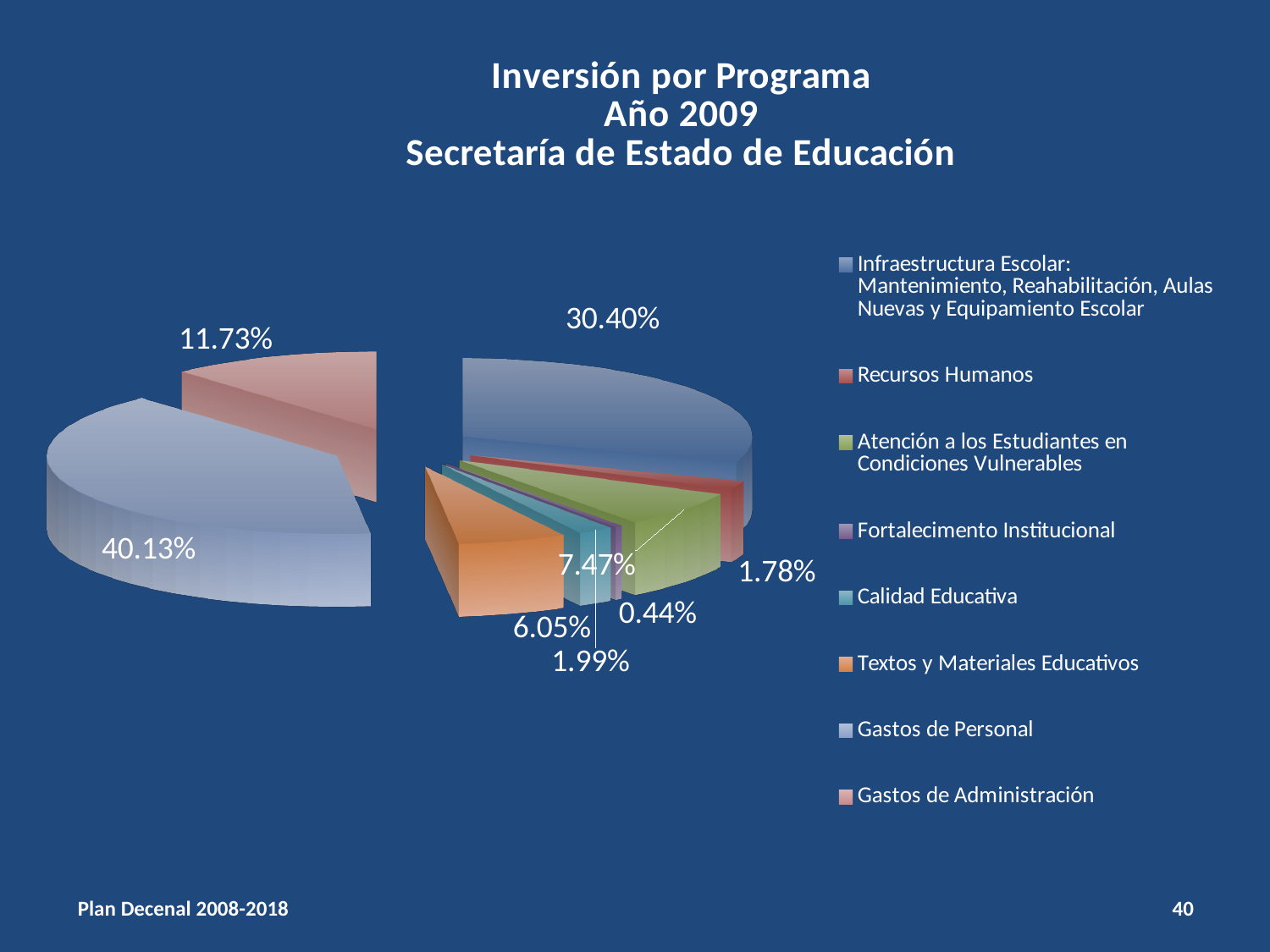
What share of investment goes to Gastos de Personal? 40.13% What percentage is shown for Gastos de Administración? 11.73% What type of chart is shown on the slide? pie chart What percentage is shown for Infraestructura Escolar: Mantenimiento, Reahabilitación, Aulas Nuevas y Equipamiento Escolar? 30.40% Which program has the largest share of investment? Gastos de Personal How many programs (slices) does the pie chart show? 8 What percentage is shown for Atención a los Estudiantes en Condiciones Vulnerables? 7.47% What year does the chart title refer to? 2009 Which program has the smallest share of investment? Fortalecimento Institucional What percentage is shown for Textos y Materiales Educativos? 6.05% What is the difference in percentage points between Gastos de Personal and Infraestructura Escolar? 9.73 Which is larger, the share for Calidad Educativa or the share for Recursos Humanos? Calidad Educativa